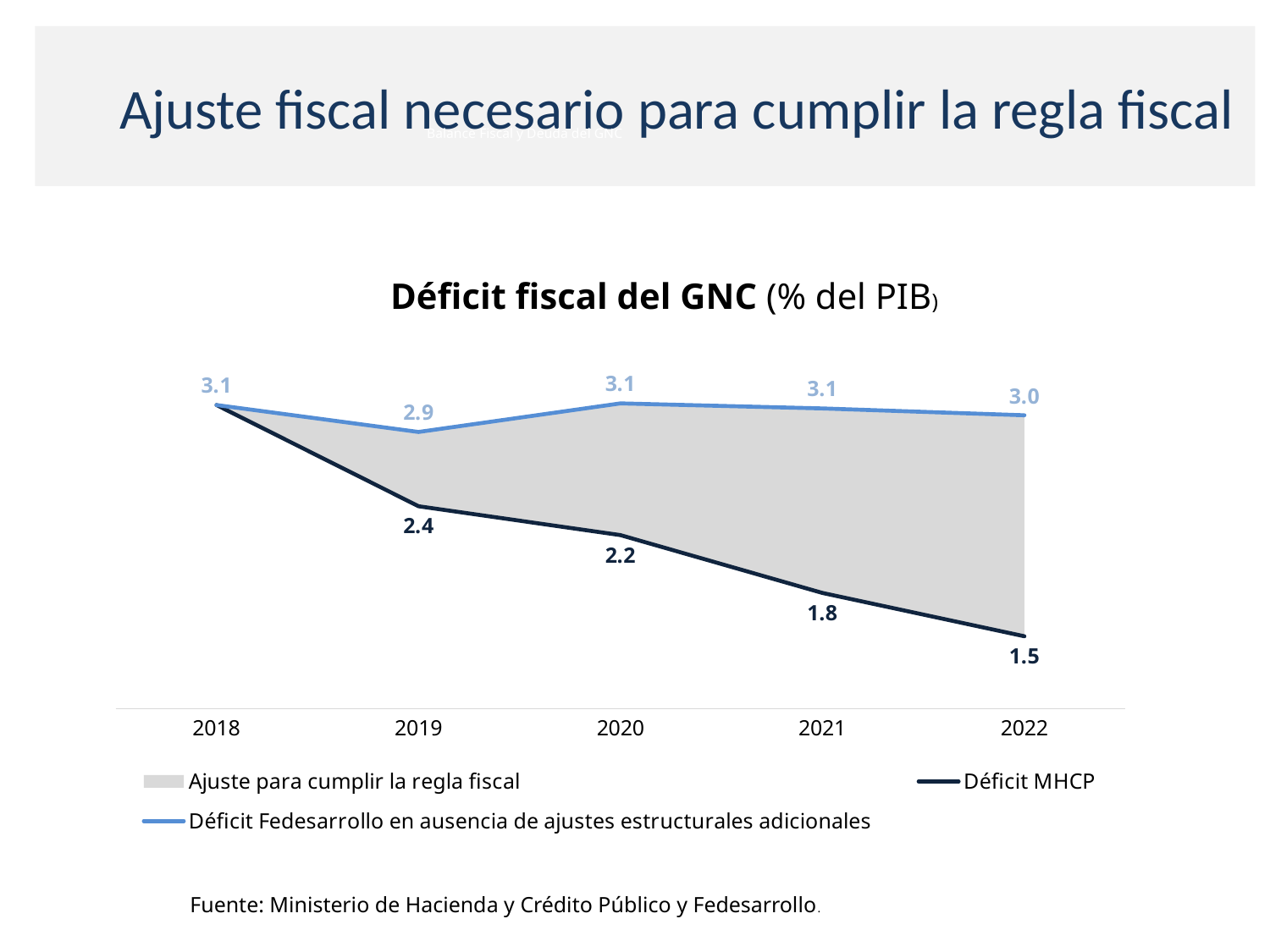
How many entries does the legend list? 3 What is the value of Déficit MHCP in 2022? 1.5 What is the value of Déficit MHCP in 2020? 2.2 What is the difference between the Déficit Fedesarrollo and Déficit MHCP values in 2022? 1.5 What is the difference between the Déficit MHCP values in 2018 and 2021? 1.3 In which year is Déficit Fedesarrollo en ausencia de ajustes estructurales adicionales lowest? 2019 What is the title of the chart? Déficit fiscal del GNC (% del PIB) What is the value of Déficit Fedesarrollo en ausencia de ajustes estructurales adicionales in 2019? 2.9 In which year is Déficit MHCP lowest? 2022 Does Déficit MHCP rise or fall from 2018 to 2022? fall How many years are shown on the x axis? 5 Which is larger in 2021: Déficit MHCP or Déficit Fedesarrollo en ausencia de ajustes estructurales adicionales? Déficit Fedesarrollo en ausencia de ajustes estructurales adicionales